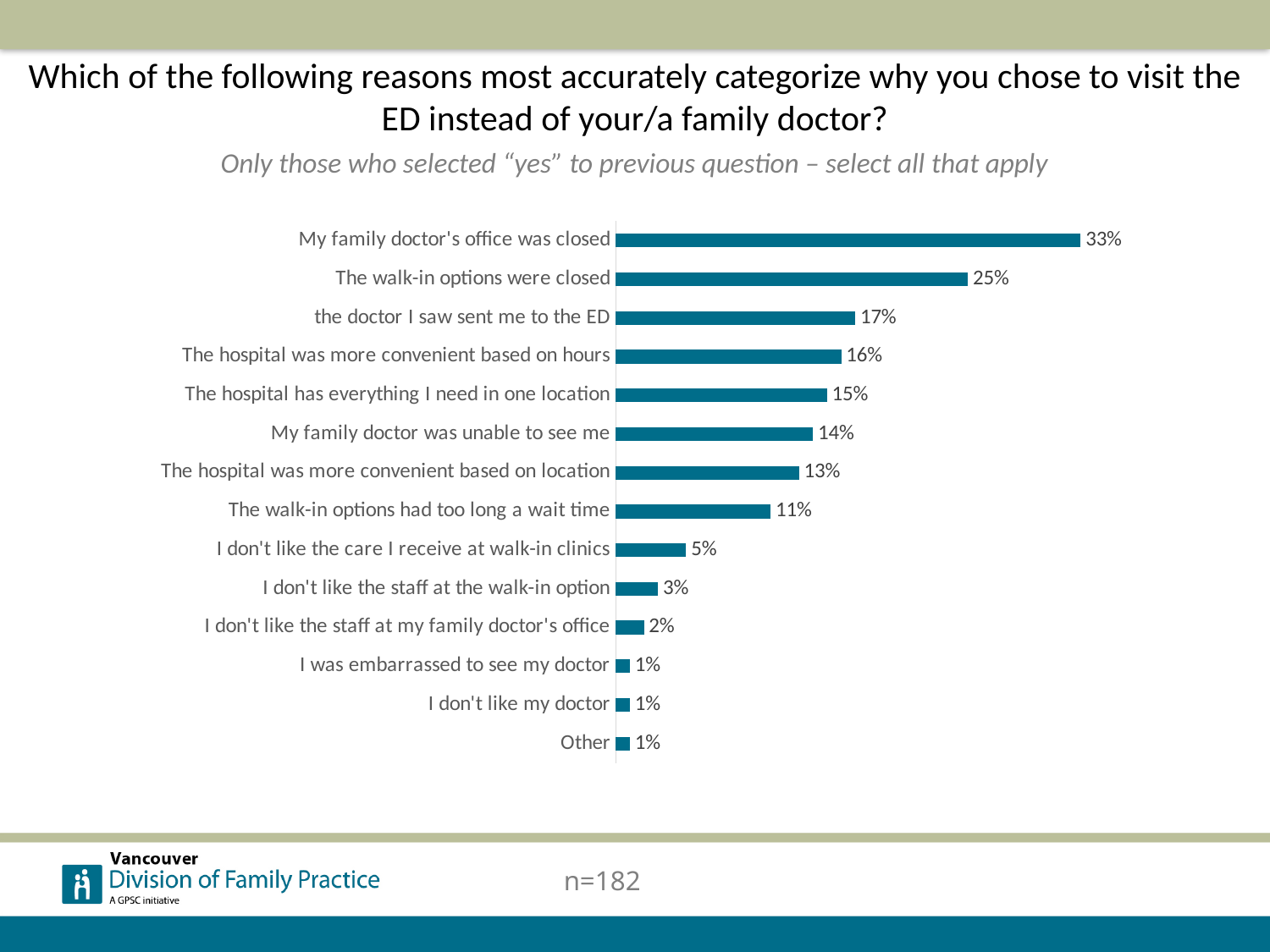
What percentage of respondents said 'My family doctor's office was closed'? 33% Which is larger: 'The hospital was more convenient based on hours' or 'My family doctor was unable to see me'? The hospital was more convenient based on hours What percentage chose 'The hospital was more convenient based on location'? 13% What is the value for 'I don't like the care I receive at walk-in clinics'? 5% What kind of chart is shown on the slide? Bar chart Which reason has the highest percentage? My family doctor's office was closed What is the value for 'The walk-in options were closed'? 25% How many reason categories are shown in the chart? 14 What is the difference between 'My family doctor's office was closed' and 'The walk-in options were closed'? 8% What is the value for 'Other'? 1% What is the sample size (n) shown on the slide? n=182 What is the difference between 'the doctor I saw sent me to the ED' and 'The walk-in options had too long a wait time'? 6%